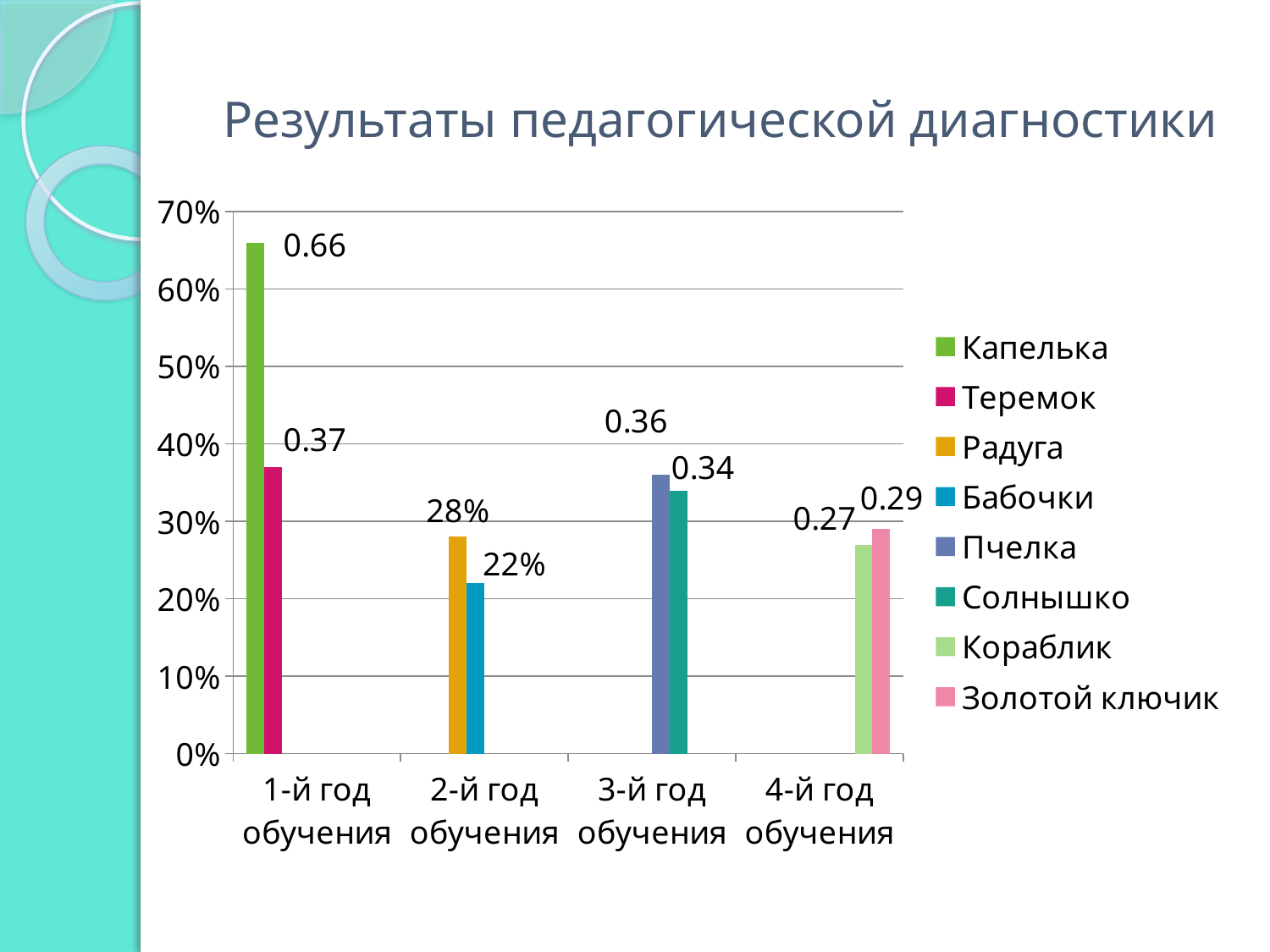
Which series has the highest value in the chart? Капелька What is the value shown for Золотой ключик? 0.29 What is the value shown for Теремок? 0.37 Which series has the lowest value in the chart? Бабочки What is the value shown for Радуга? 28% What is the value shown for Капелька in the chart? 0.66 What is the title of the chart? Результаты педагогической диагностики Which is larger, the value for Пчелка or the value for Солнышко? Пчелка How many categories are shown on the x axis? 4 What is the difference between the values for Капелька and Теремок? 0.29 How many series does the legend list? 8 What is the value shown for Бабочки? 22%